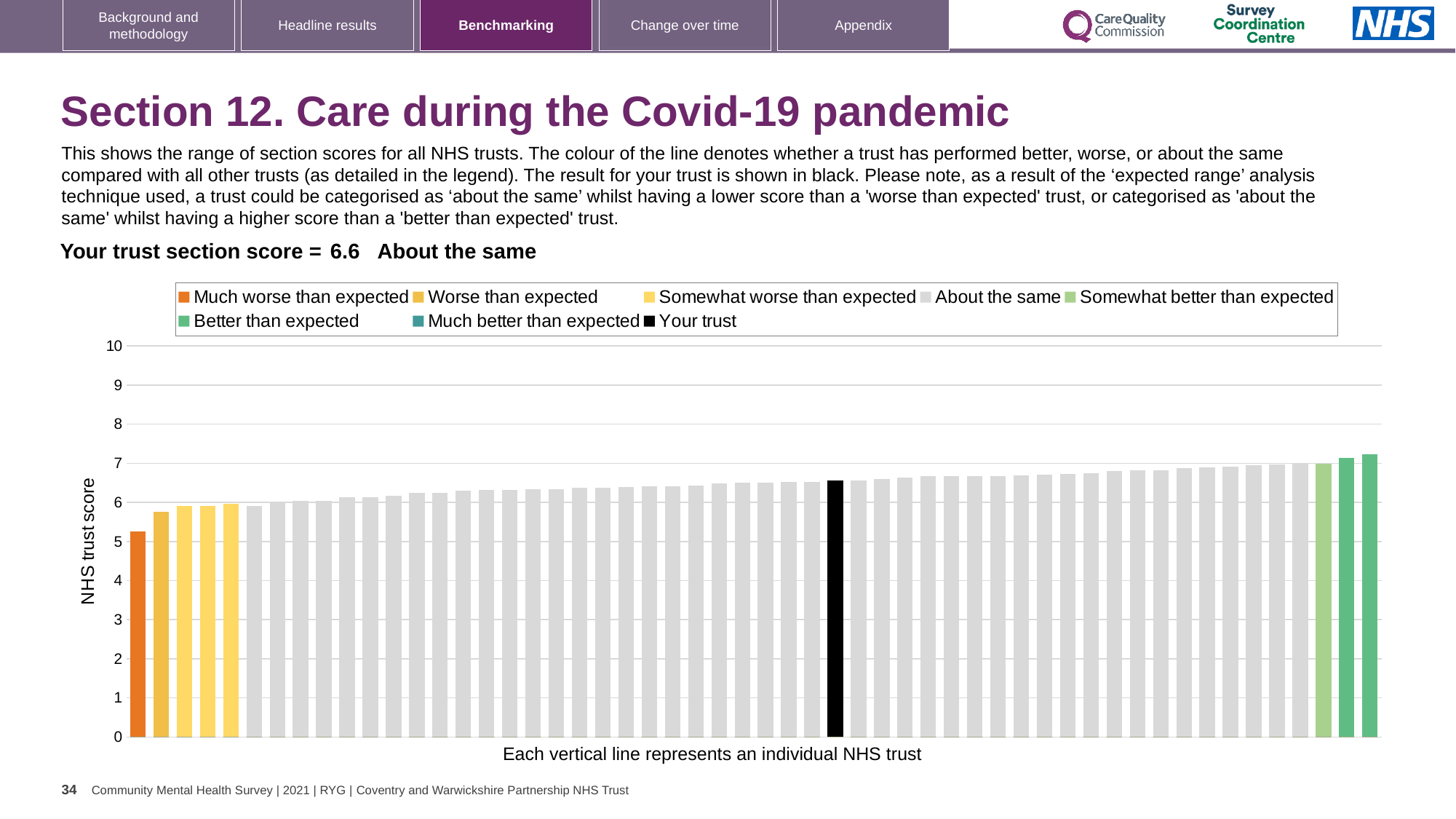
Is the value of the shortest bar (the orange 'Much worse than expected' bar) greater or less than 6? less Which legend category does the tallest bar in the chart belong to? Better than expected What is the label on the vertical axis of the chart? NHS trust score Is the value of the black 'Your trust' bar greater or less than 6? greater Do the bar values rise or fall from left to right along the x axis? rise What kind of chart is shown on the slide? bar chart How many entries does the chart legend list? 8 Which legend category does the shortest bar in the chart belong to? Much worse than expected Which is taller: the black 'Your trust' bar or the orange 'Much worse than expected' bar? Your trust Is the value of the tallest bar in the chart greater or less than 7? greater How many bars are coloured orange ('Much worse than expected')? 1 What is the section score for your trust shown on the slide? 6.6